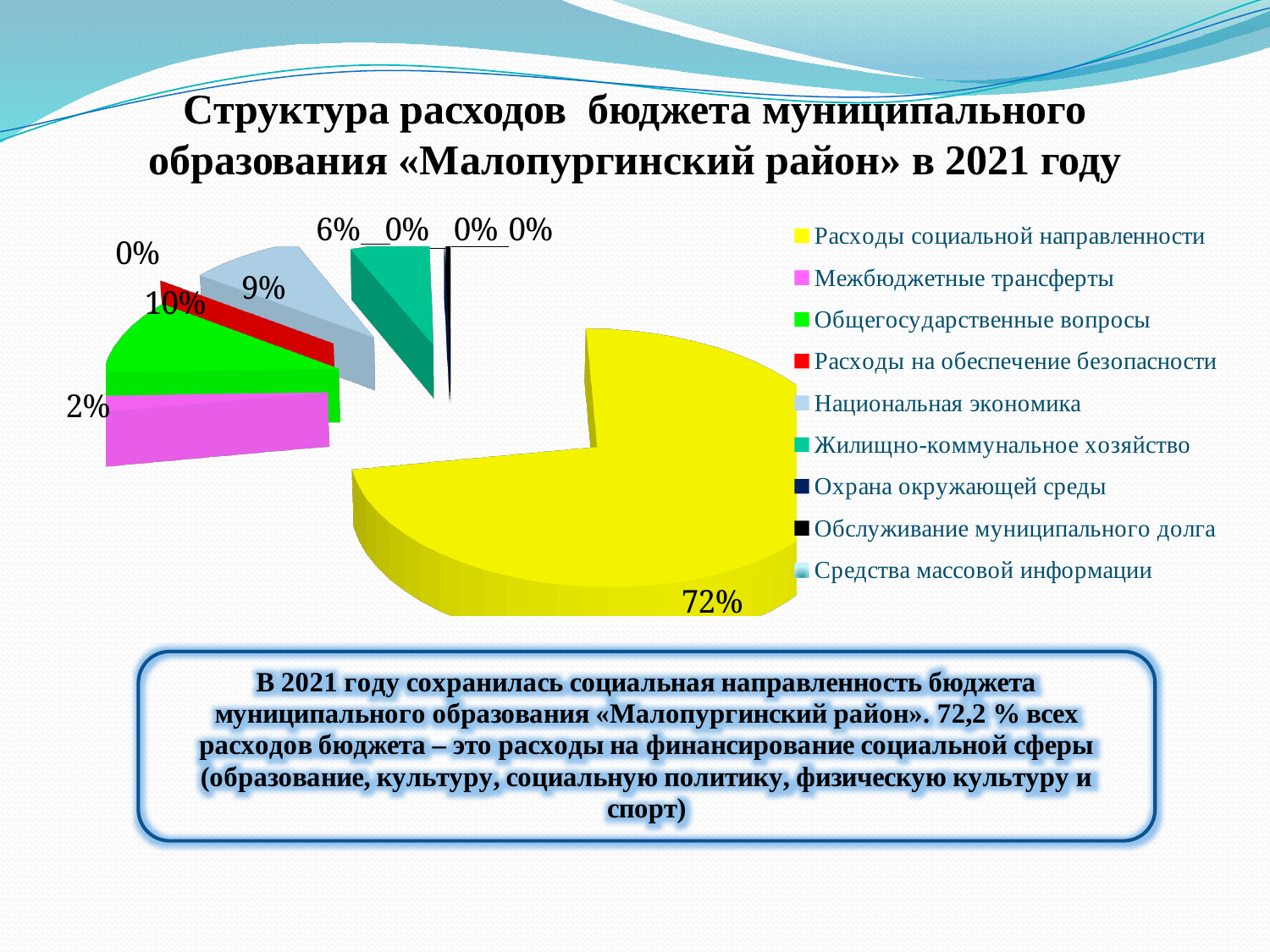
Which is larger: the slice labelled 9% or the slice labelled 6%? the slice labelled 9% What is the title of the chart on the slide? Структура расходов бюджета муниципального образования «Малопургинский район» в 2021 году How many categories does the legend of the pie chart list? 9 Which category has the largest share of the pie chart? Расходы социальной направленности Which colour represents Расходы социальной направленности in the legend? yellow What kind of chart is shown on the slide? pie chart Is the share for Расходы социальной направленности greater or less than 50%? greater What is the smallest percentage label shown on the pie chart? 0% What share of the pie is labelled for Расходы социальной направленности? 72% How many slices of the pie chart are labelled 0%? 4 What is the largest percentage label shown on the pie chart? 72% What is the difference between the largest labelled share (72%) and the second largest labelled share (10%)? 62%